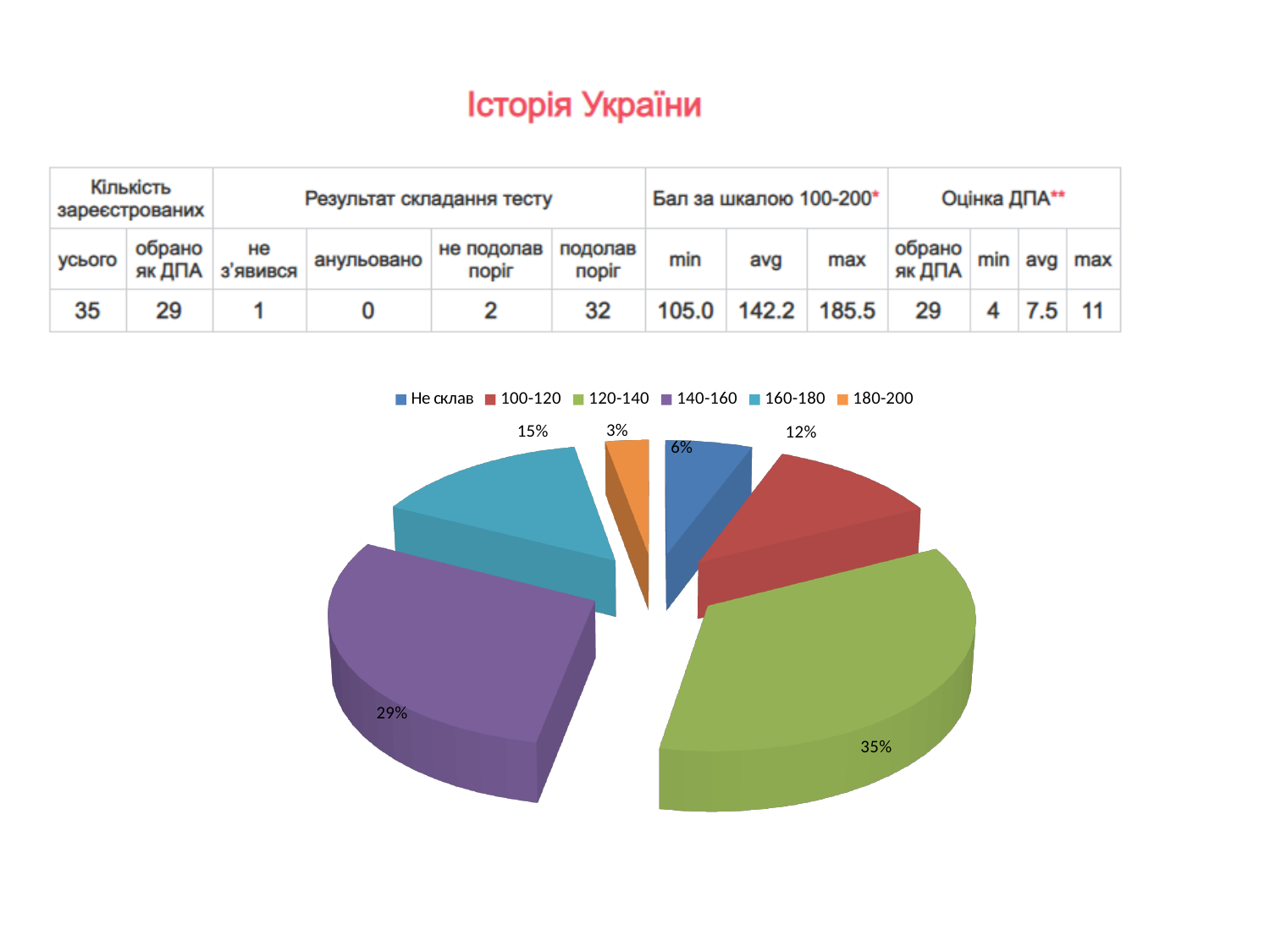
What is the value shown for the 160-180 slice? 15% Which slice is larger: 160-180 or 100-120? 160-180 What colour is the 140-160 slice in the pie chart? purple What is the value shown for the 100-120 slice? 12% Which category has the smallest slice of the pie? 180-200 Which category has the largest slice of the pie? 120-140 What share of the pie does the 120-140 slice represent? 35% How many categories does the pie chart's legend list? 6 What is the difference in percentage points between the 120-140 slice and the 140-160 slice? 6 What kind of chart is shown on the slide? pie chart What share of the pie does the 140-160 slice represent? 29% What is the value shown for the 'Не склав' slice? 6%